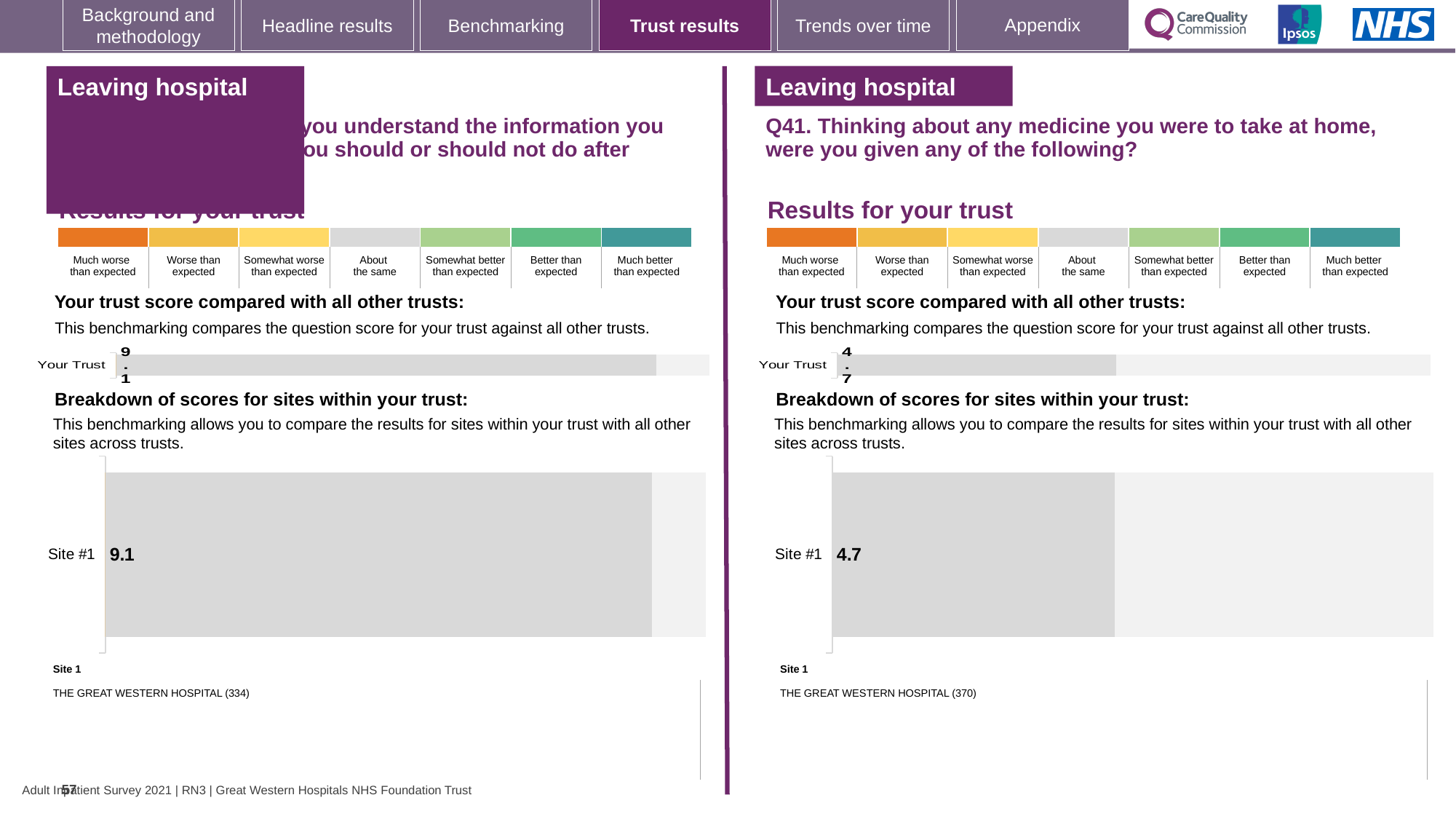
How many sites are shown on the left-hand 'Breakdown of scores for sites within your trust' chart? 1 Which is larger: the Site #1 score on the left-hand breakdown chart or the Site #1 score on the right-hand (Q41) breakdown chart? The left-hand chart (9.1) What is the label of the single site shown on the right-hand (Q41) breakdown chart? Site #1 What type of chart is used to show the Site #1 score on the right-hand (Q41) breakdown chart? Bar chart On the right-hand 'Breakdown of scores for sites within your trust' chart (Q41), what is the score for Site #1? 4.7 What is the difference between the Site #1 score on the left-hand breakdown chart and the Site #1 score on the right-hand (Q41) breakdown chart? 4.4 Which survey question does the right-hand set of charts relate to? Q41. Thinking about any medicine you were to take at home, were you given any of the following? On the left-hand 'Your trust score compared with all other trusts' chart, what is the score shown for Your Trust? 9.1 Which is larger: the Your Trust score on the left-hand chart or the Your Trust score on the right-hand (Q41) chart? The left-hand chart (9.1) On the left-hand 'Breakdown of scores for sites within your trust' chart, what is the score for Site #1? 9.1 How many sites are shown on the right-hand 'Breakdown of scores for sites within your trust' chart (Q41)? 1 On the right-hand 'Your trust score compared with all other trusts' chart (Q41), what is the score shown for Your Trust? 4.7